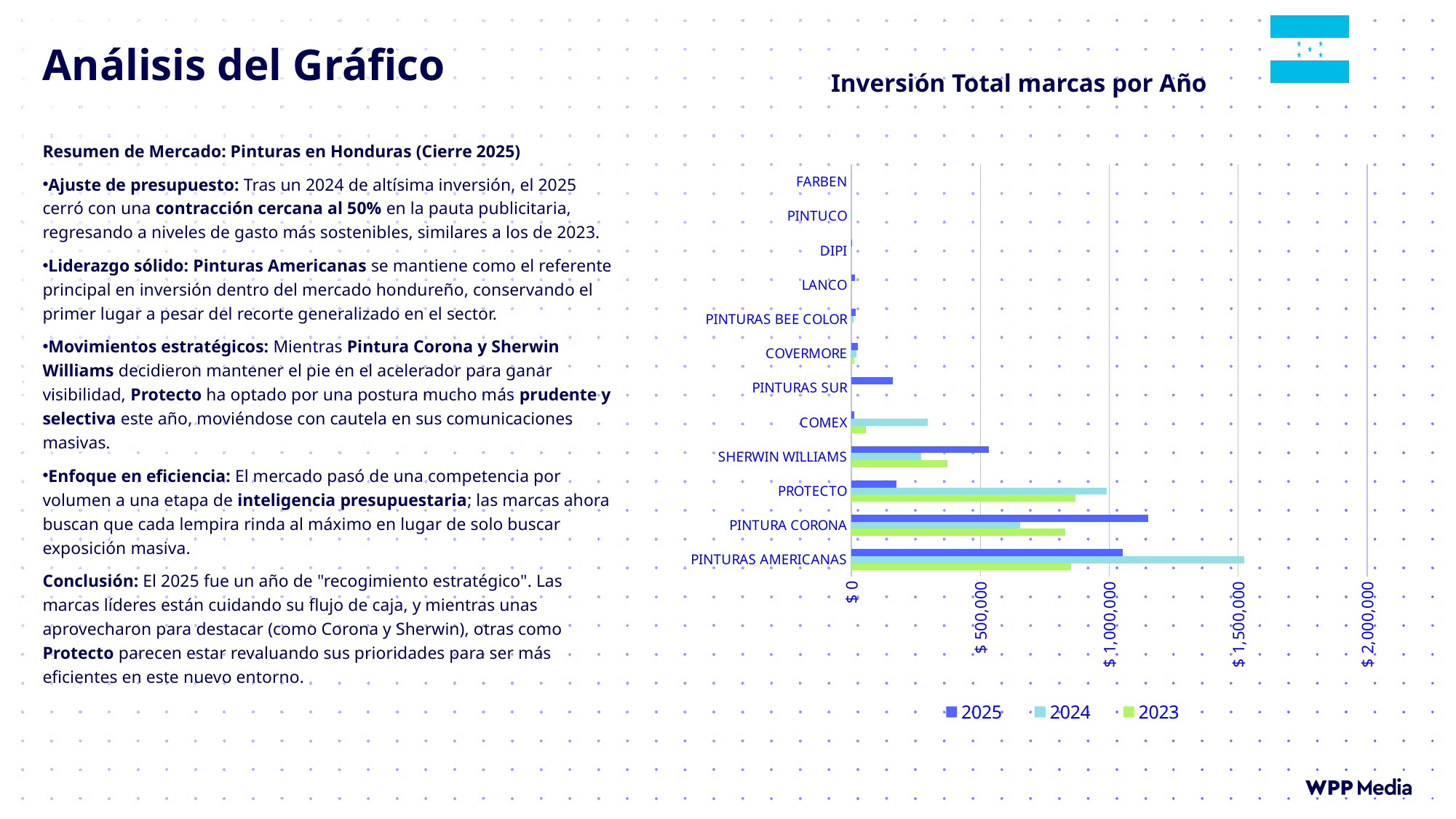
Which brand has the highest 2025 value? PINTURA CORONA Which brand has the highest 2024 value? PINTURAS AMERICANAS Is the 2024 value for PINTURA CORONA greater or less than $ 500,000? greater What kind of chart is shown on the slide? bar chart Is the 2024 value for COMEX greater or less than $ 500,000? less How many series does the chart legend list? 3 Which years are listed in the chart legend? 2025, 2024, 2023 What is the title of the chart? Inversión Total marcas por Año Is the 2023 value for PROTECTO greater or less than $ 1,000,000? less How many brands are shown on the chart? 12 Which is larger, the 2025 value for PINTURA CORONA or the 2025 value for PROTECTO? PINTURA CORONA